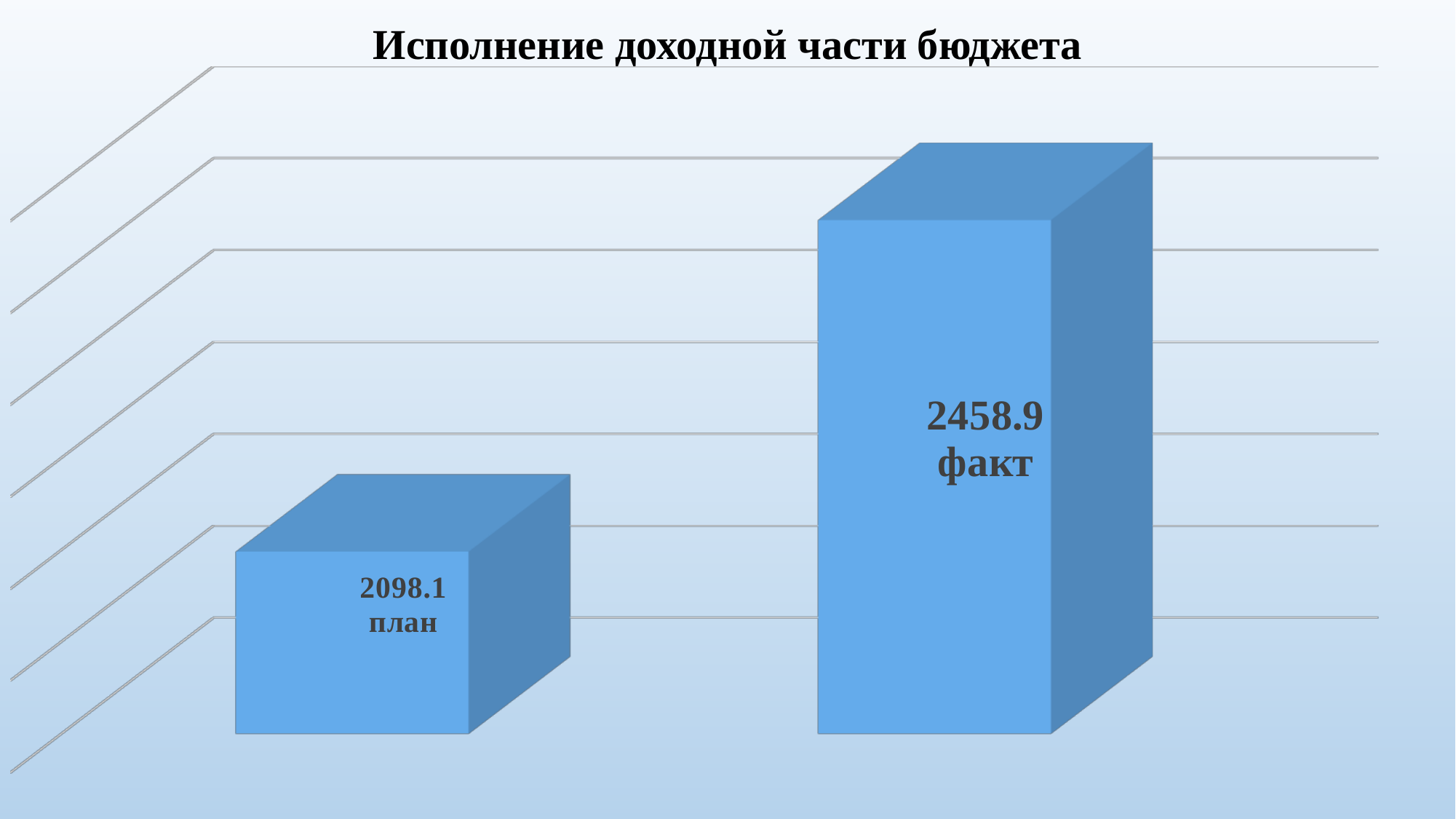
What colour are the bars in the chart? blue How many bars are shown in the chart? 2 Which category has the highest value? факт What is the title of the chart? Исполнение доходной части бюджета Do the values rise or fall from план to факт? rise What kind of chart is shown on the slide? bar chart What is the value for факт (actual)? 2458.9 Which is larger, план or факт? факт What is the value for план (plan)? 2098.1 What is the difference between the факт and план values? 360.8 Which category has the lowest value? план